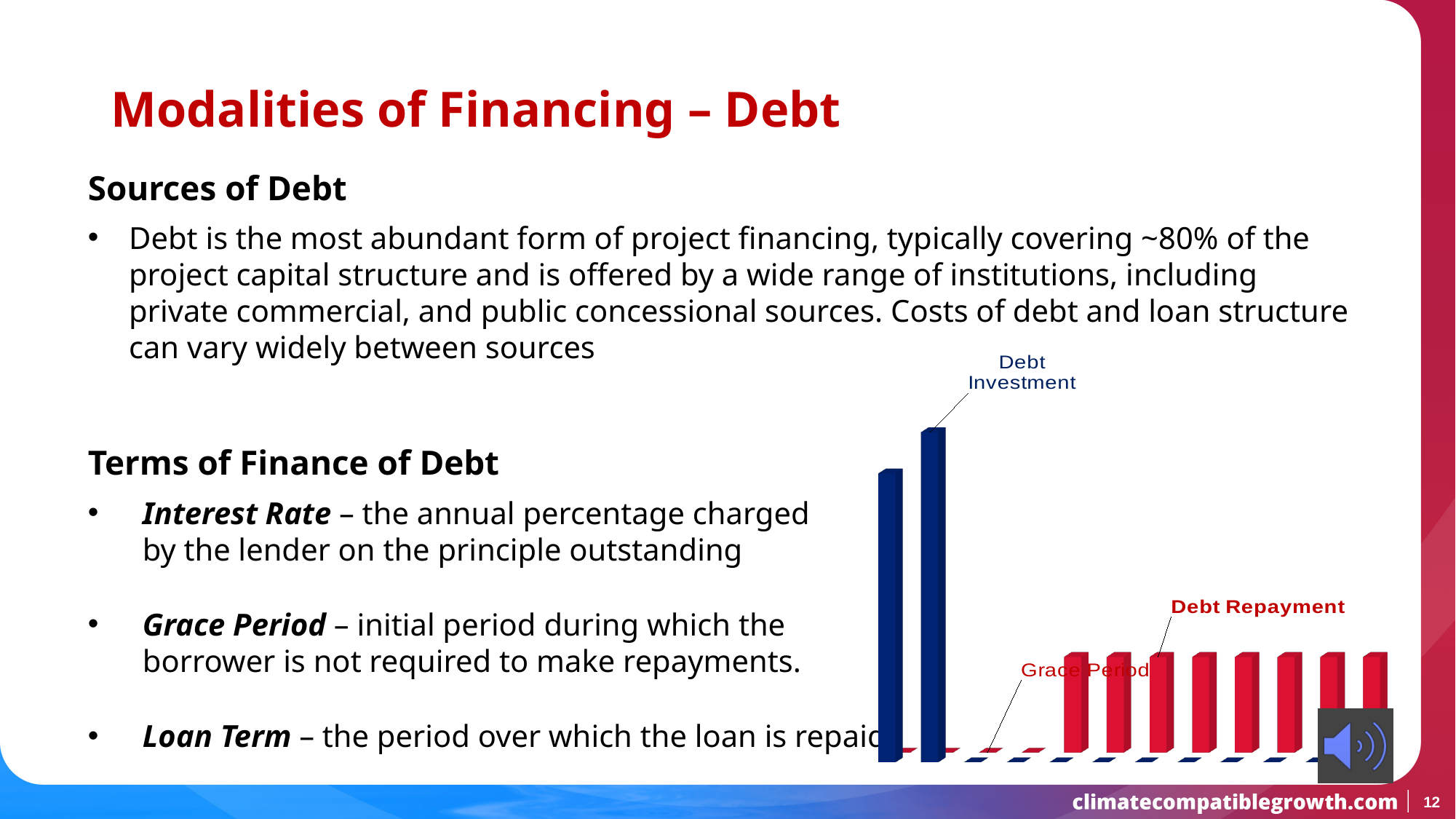
What colour are the Debt Repayment bars in the chart? red What kind of chart is shown on the slide? bar chart How many red Debt Repayment bars are shown in the chart? 8 How many dark blue bars labelled Debt Investment are shown in the chart? 2 Of the two Debt Investment bars, which one is taller, the first or the second? the second Do the Debt Repayment bars rise, fall or stay level from left to right? stay level How many bars in total are plotted in the chart? 10 What label is given to the gap between the Debt Investment bars and the Debt Repayment bars? Grace Period Which is taller in the chart: the Debt Investment bars or the Debt Repayment bars? Debt Investment bars